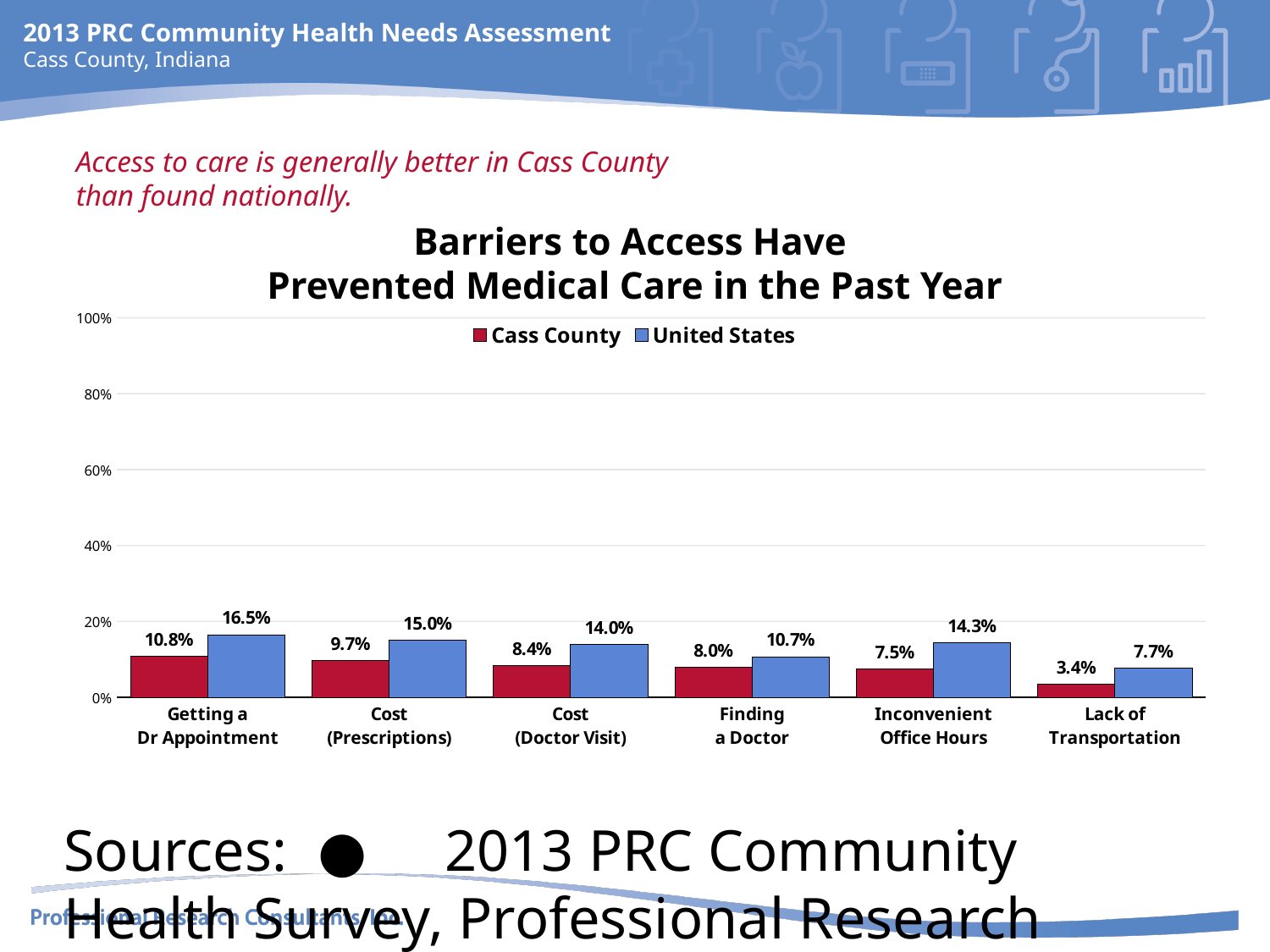
What is the title of the chart? Barriers to Access Have Prevented Medical Care in the Past Year What is the United States value for Cost (Prescriptions)? 15.0% Which category has the highest United States value? Getting a Dr Appointment How many series does the legend list? 2 What is the difference between the United States and Cass County values for Inconvenient Office Hours? 6.8% What kind of chart is shown? bar chart Which category has the lowest Cass County value? Lack of Transportation How many barrier categories are shown on the x axis? 6 Which is larger for Cost (Doctor Visit): the Cass County value or the United States value? United States What is the Cass County value for Lack of Transportation? 3.4% What is the Cass County value for Getting a Dr Appointment? 10.8% Is the United States value for Finding a Doctor greater or less than 20%? less